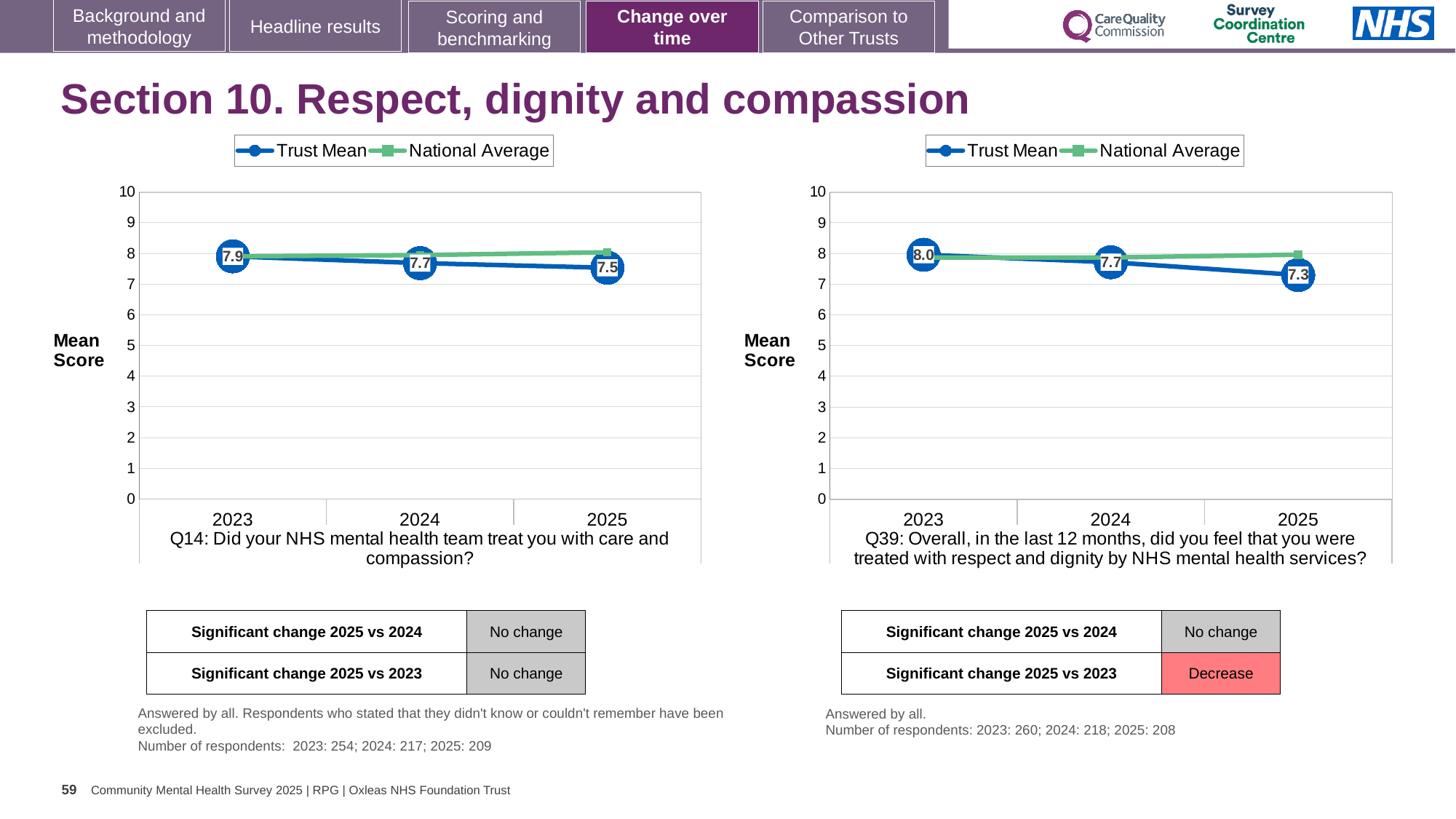
In the left chart (Q14), is the Trust Mean for 2025 greater or less than 8? less In the left chart (Q14), what is the Trust Mean for 2023? 7.9 How many years are plotted on the x axis of the left chart (Q14)? 3 In the left chart (Q14), which year has the highest Trust Mean? 2023 In the right chart (Q39), what is the Trust Mean for 2023? 8.0 How many series does the legend of the right chart (Q39) list? 2 In the left chart (Q14), does the Trust Mean rise or fall from 2023 to 2025? fall In the left chart (Q14), what is the Trust Mean for 2025? 7.5 What kind of chart is the right chart (Q39)? line chart In the right chart (Q39), which year has the lowest Trust Mean? 2025 In the right chart (Q39), what is the Trust Mean for 2025? 7.3 In the right chart (Q39), what is the difference between the Trust Mean in 2023 and in 2025? 0.7